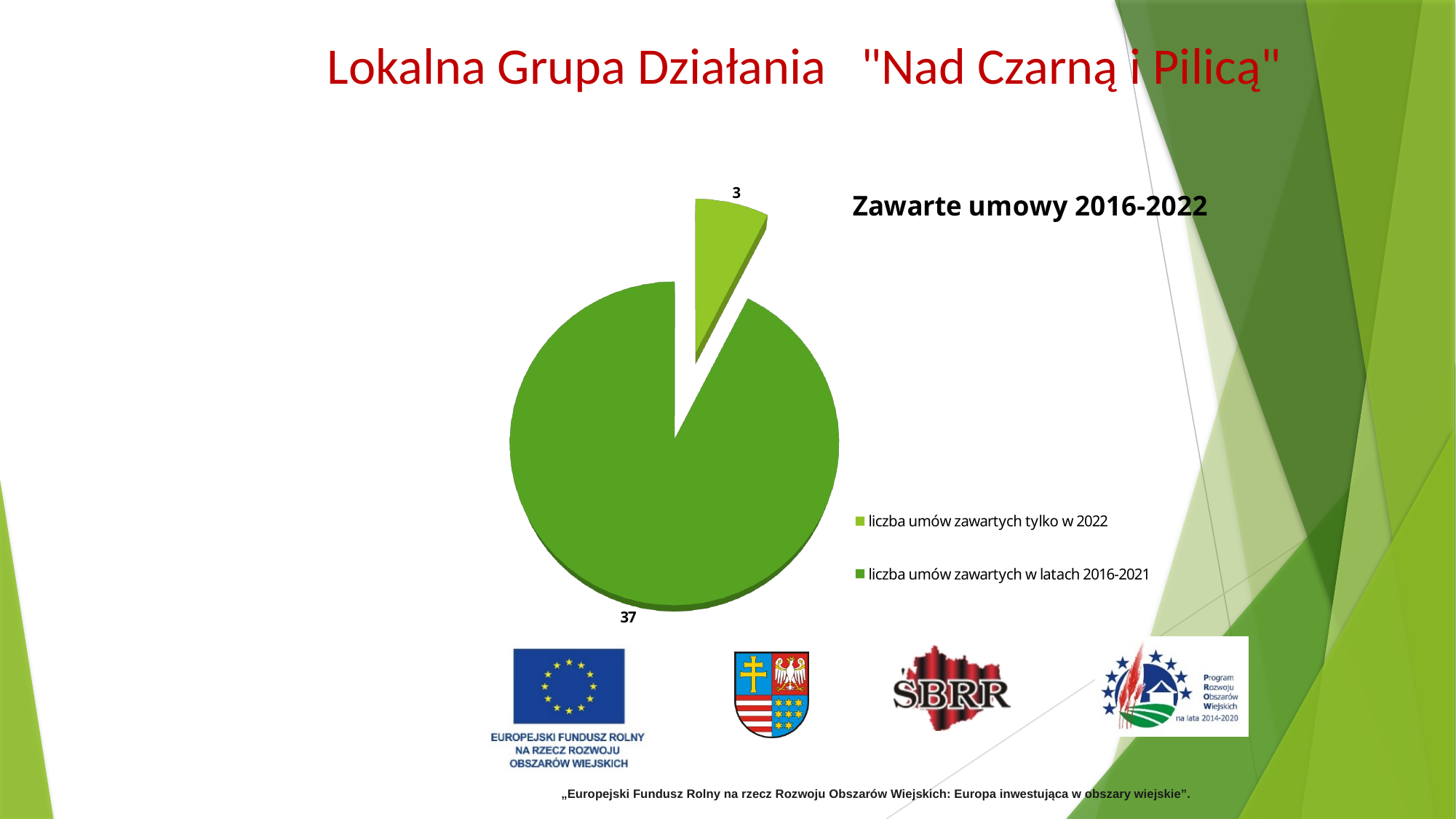
What kind of chart is shown on the slide? pie chart How many entries does the legend list? 2 What is the title of the chart? Zawarte umowy 2016-2022 Which is larger: the value for "liczba umów zawartych tylko w 2022" or for "liczba umów zawartych w latach 2016-2021"? liczba umów zawartych w latach 2016-2021 Which category has the largest slice? liczba umów zawartych w latach 2016-2021 What is the value for "liczba umów zawartych w latach 2016-2021"? 37 What is the value for "liczba umów zawartych tylko w 2022"? 3 Which category has the smallest slice? liczba umów zawartych tylko w 2022 How many slices does the pie chart have? 2 What share of the pie does "liczba umów zawartych tylko w 2022" represent? 7.5% What is the total of all slices in the pie chart? 40 What is the difference between the number of contracts concluded in 2016-2021 and those concluded only in 2022? 34